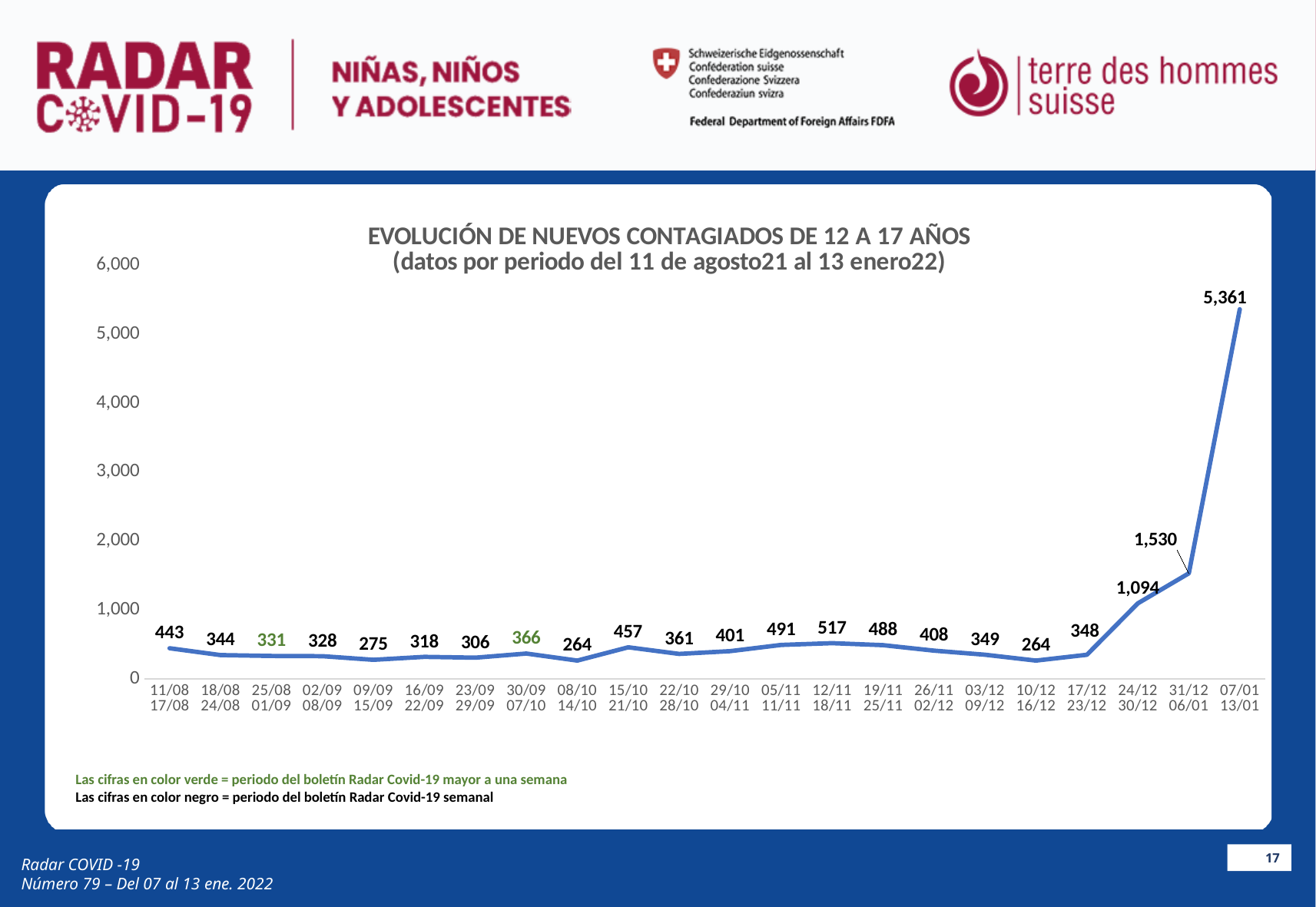
What is the value for the period 12/11–18/11? 517 Do the values rise or fall over the last three periods of the chart? rise Which period has the highest value? 07/01–13/01 What is the value for the period 11/08–17/08? 443 Which is larger, the value for 15/10–21/10 or the value for 22/10–28/10? 15/10–21/10 What kind of chart is shown on the slide? line chart What is the value for the period 31/12–06/01? 1,530 What is the difference between the values for 31/12–06/01 and 24/12–30/12? 436 What is the lowest value plotted on the chart? 264 Is the value for 24/12–30/12 greater or less than 1,000? greater What is the difference between the values for 07/01–13/01 and 31/12–06/01? 3,831 How many periods are plotted on the chart? 22